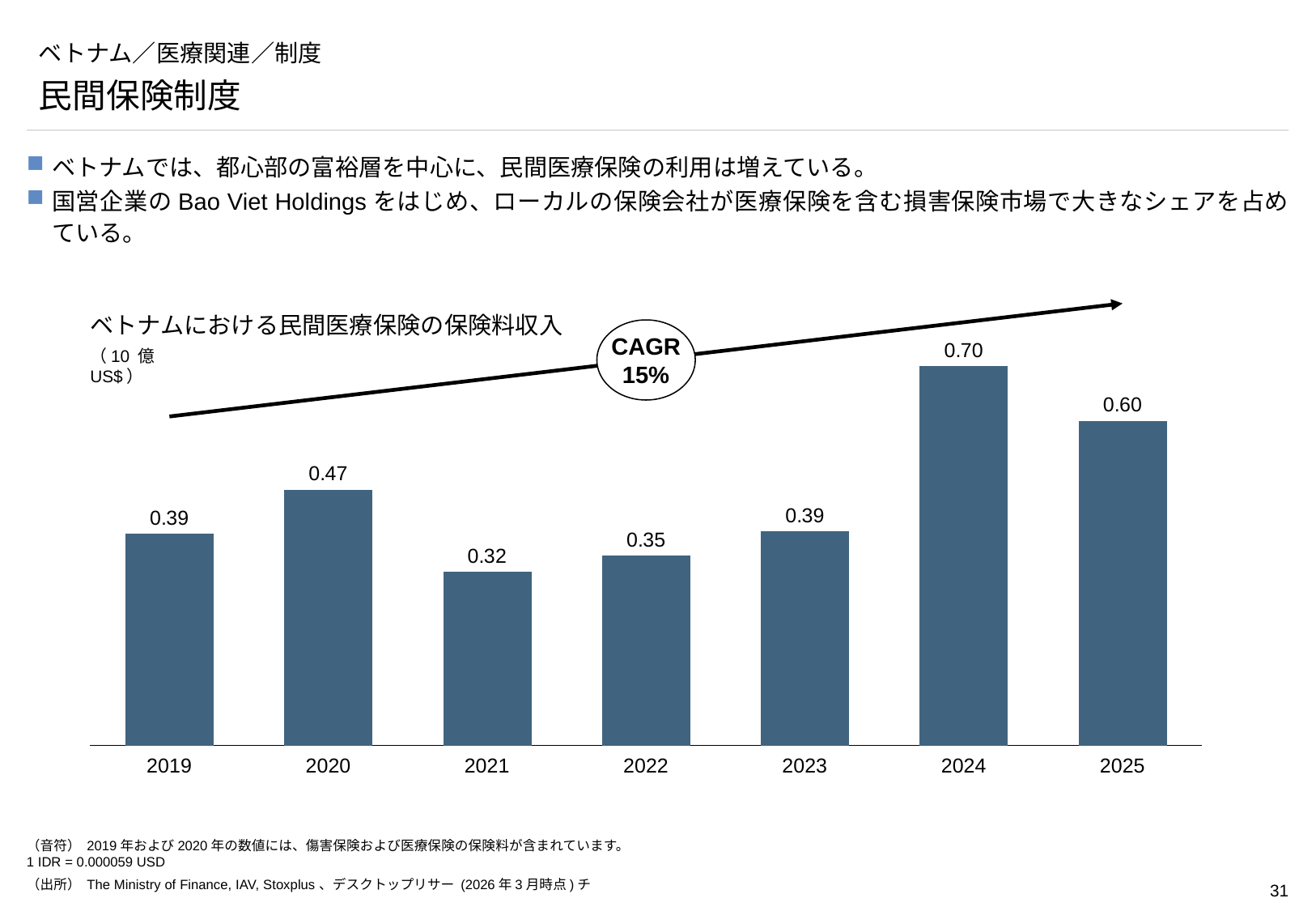
What is the value for 2020? 0.47 How many years are shown on the x axis? 7 What is the value for 2021? 0.32 Which year has the highest value? 2024 Does the value rise or fall from 2021 to 2024? Rise Which year has the lowest value? 2021 What is the difference between the values for 2020 and 2021? 0.15 What is the value for 2024? 0.70 What CAGR is shown in the circle on the chart? 15% Which is larger, the value for 2022 or the value for 2023? 2023 What kind of chart is this? Bar chart What is the difference between the values for 2024 and 2025? 0.10